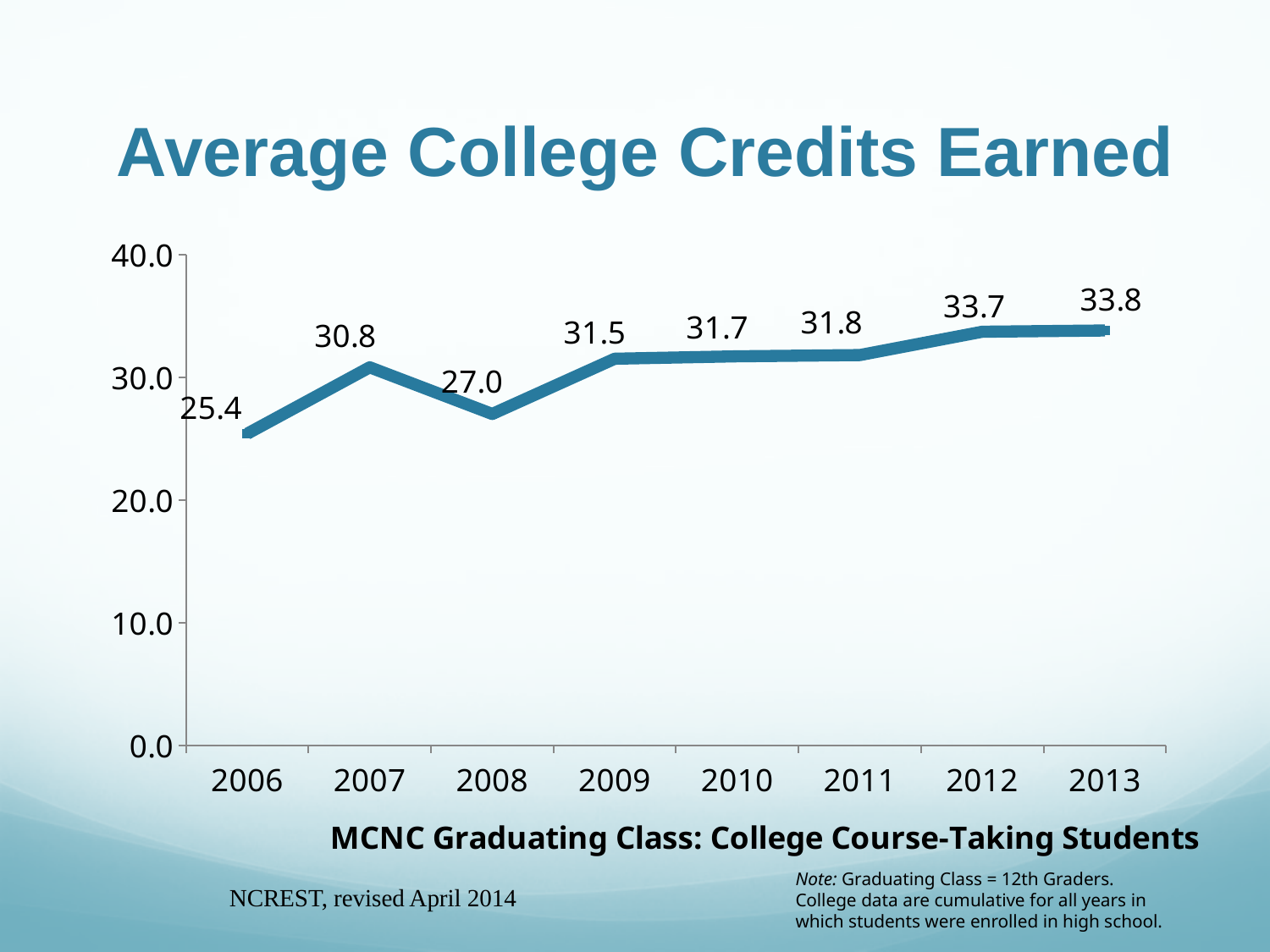
Which year has the lowest average college credits earned? 2006 What is the average college credits earned for 2012? 33.7 Is the value for 2009 greater or less than 30.0? greater Which year has a larger value, 2007 or 2008? 2007 What is the title of the chart? Average College Credits Earned What is the average college credits earned for 2006? 25.4 What is the difference between the values for 2007 and 2008? 3.8 What kind of chart is shown on the slide? Line chart Which year has the highest average college credits earned? 2013 How many years are plotted on the chart? 8 What is the average college credits earned for 2008? 27.0 What is the difference between the values for 2013 and 2006? 8.4